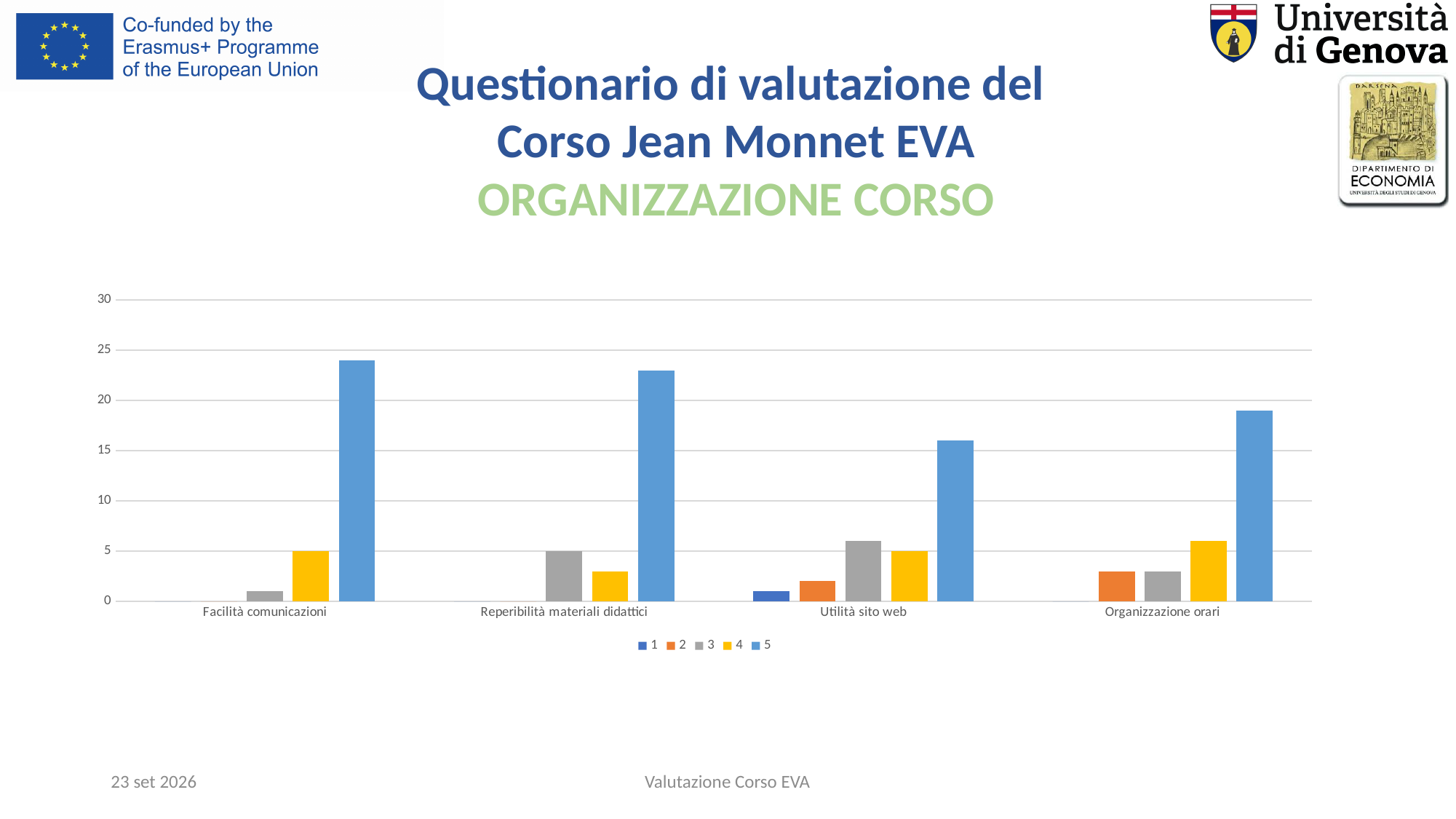
How many series does the chart's legend list? 5 Is the value of series 5 for Facilità comunicazioni greater or less than 20? greater What is the value of series 3 for Reperibilità materiali didattici? 5 Is the value of series 5 for Organizzazione orari greater or less than 15? greater Is the value of series 5 for Utilità sito web greater or less than 20? less What is the value of series 4 for Facilità comunicazioni? 5 How many categories are shown on the x axis of the chart? 4 Which category has the highest value for series 5? Facilità comunicazioni Which category has the lowest value for series 5? Utilità sito web What kind of chart is shown on the slide? bar chart What is the value of series 4 for Utilità sito web? 5 Which is larger: series 5 for Reperibilità materiali didattici or series 5 for Organizzazione orari? Reperibilità materiali didattici